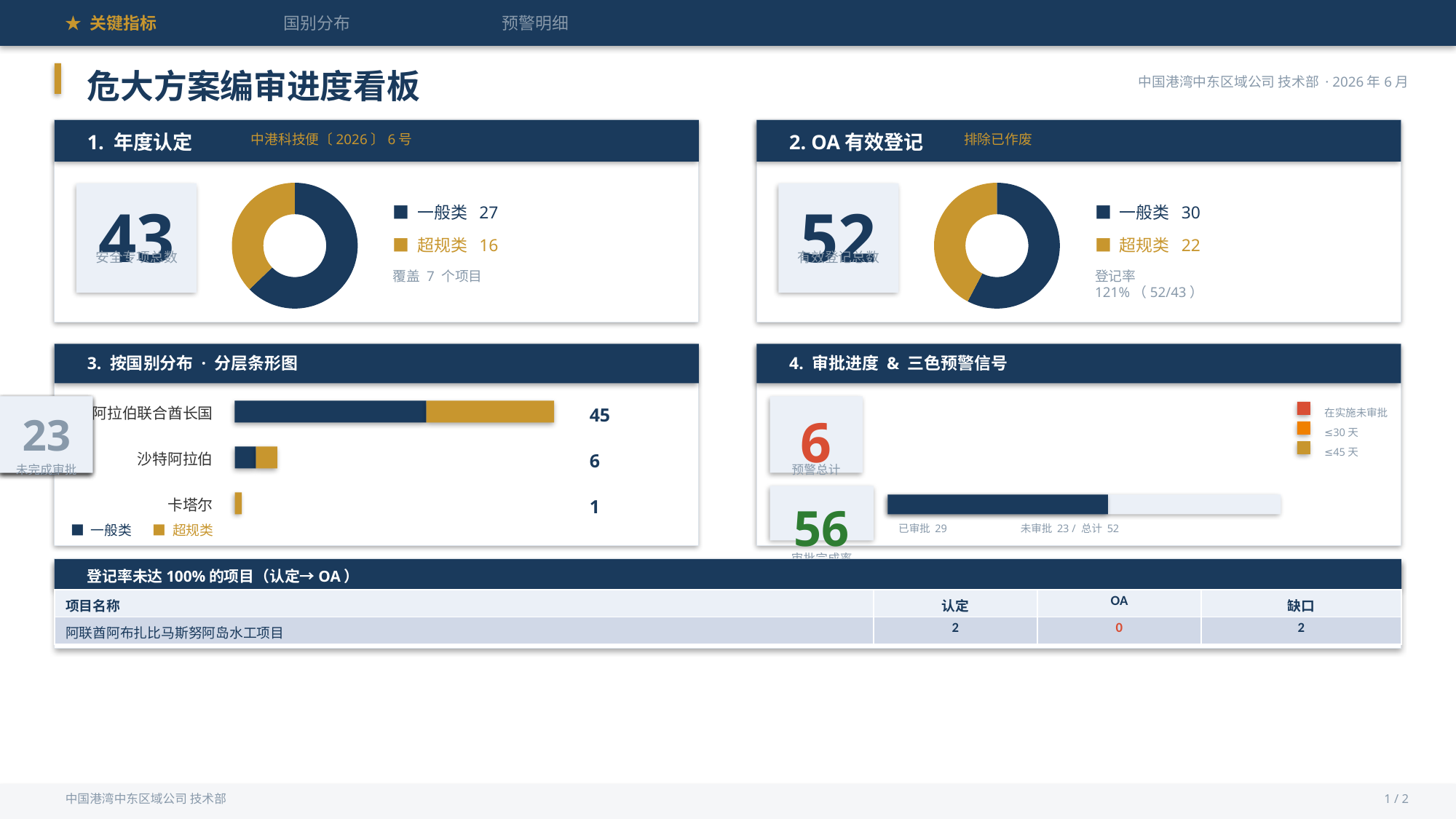
In the "3. 按国别分布 · 分层条形图" chart, how many countries are shown? 3 In the "4. 审批进度 & 三色预警信号" progress bar, what is the value for 已审批? 29 In the "2. OA 有效登记" donut chart, what is the value for 一般类? 30 In the "3. 按国别分布 · 分层条形图" chart, what is the total for 沙特阿拉伯? 6 In the "3. 按国别分布 · 分层条形图" chart, how many series does the legend list? 2 In the "3. 按国别分布 · 分层条形图" chart, which country has the lowest total? 卡塔尔 What kind of chart is used in the "3. 按国别分布 · 分层条形图" panel? Stacked bar chart In the "3. 按国别分布 · 分层条形图" chart, what is the difference between the totals for 阿拉伯联合酋长国 and 沙特阿拉伯? 39 In the "2. OA 有效登记" donut chart, which is larger, 一般类 or 超规类? 一般类 In the "1. 年度认定" donut chart, what is the value for 超规类? 16 In the "1. 年度认定" donut chart, what is the difference between 一般类 and 超规类? 11 In the "3. 按国别分布 · 分层条形图" chart, which country has the highest total? 阿拉伯联合酋长国